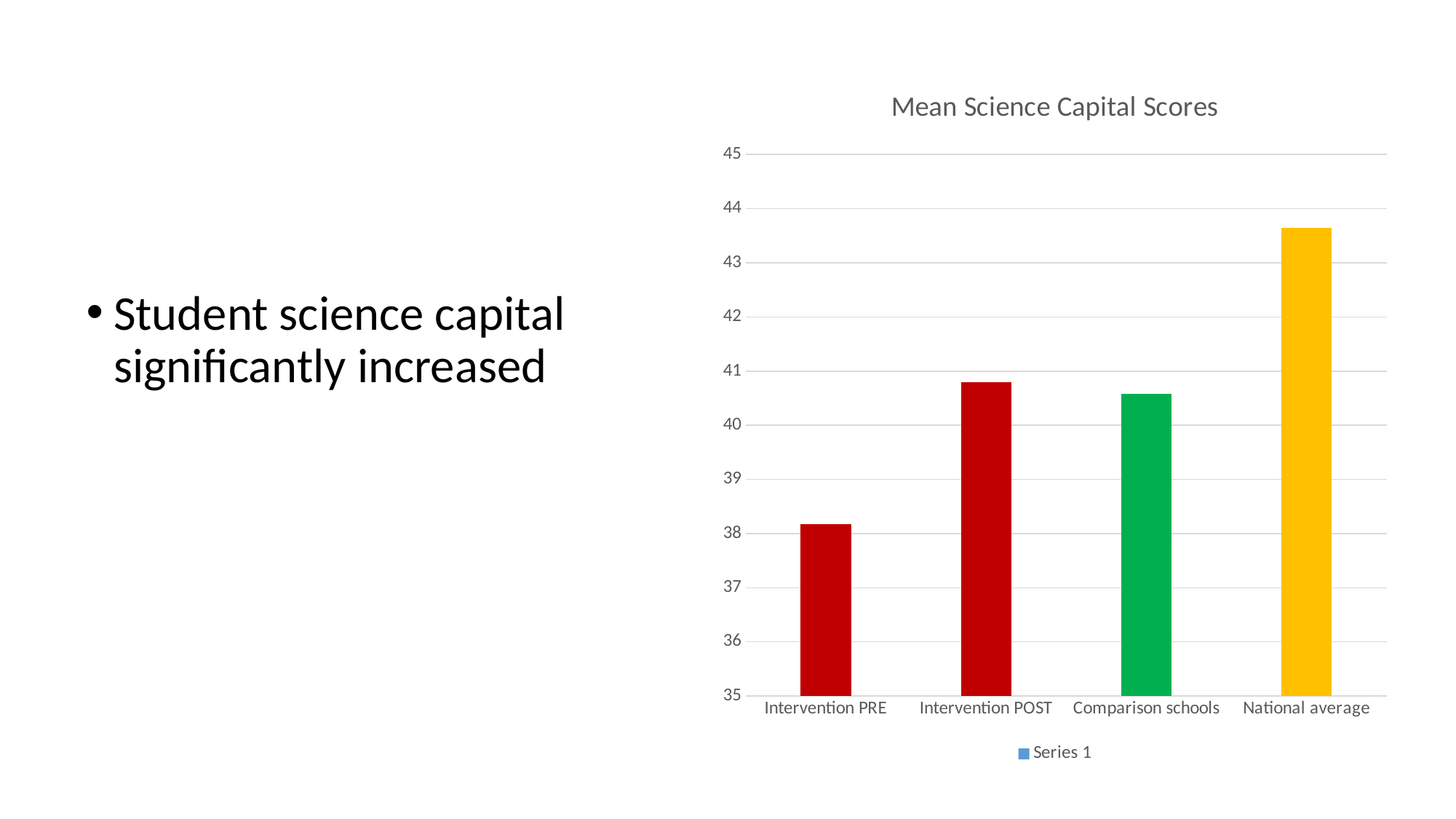
How many series does the chart legend list? 1 What type of chart is shown on the slide? bar chart How many categories are shown on the x axis of the chart? 4 Which is larger, the value for Comparison schools or the value for National average? National average Which category has the lowest mean science capital score? Intervention PRE What colour is the bar for National average? yellow What is the title of the chart? Mean Science Capital Scores Which category has the highest mean science capital score? National average Is the value for Intervention PRE greater or less than 39? less Which is larger, the value for Intervention PRE or the value for Intervention POST? Intervention POST Is the value for Intervention POST greater or less than 40? greater Is the value for National average greater or less than 43? greater